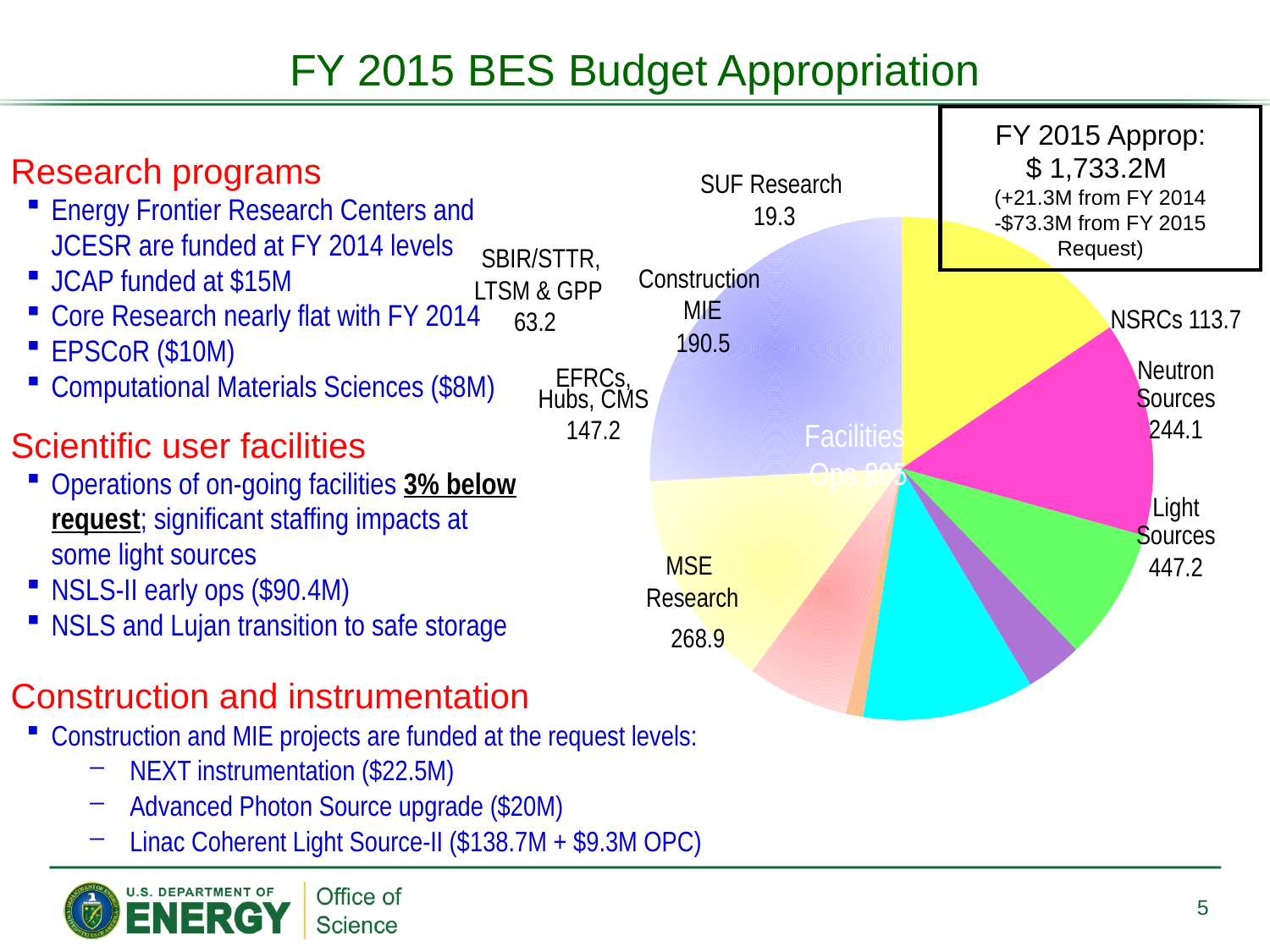
What value is shown for MSE Research in the pie chart? 268.9 What value is shown for Light Sources in the pie chart? 447.2 What value is shown for Neutron Sources in the pie chart? 244.1 Which is larger in the pie chart, Light Sources or Neutron Sources? Light Sources What is the difference between the Light Sources value and the Neutron Sources value in the pie chart? 203.1 Which labeled category in the pie chart has the smallest value? SUF Research What total FY 2015 appropriation is shown in the box next to the pie chart? $ 1,733.2M What value is shown for SBIR/STTR, LTSM & GPP in the pie chart? 63.2 What value is shown for NSRCs in the pie chart? 113.7 What kind of chart is shown on the slide? Pie chart What value is shown for Construction MIE in the pie chart? 190.5 What value is shown for EFRCs, Hubs, CMS in the pie chart? 147.2